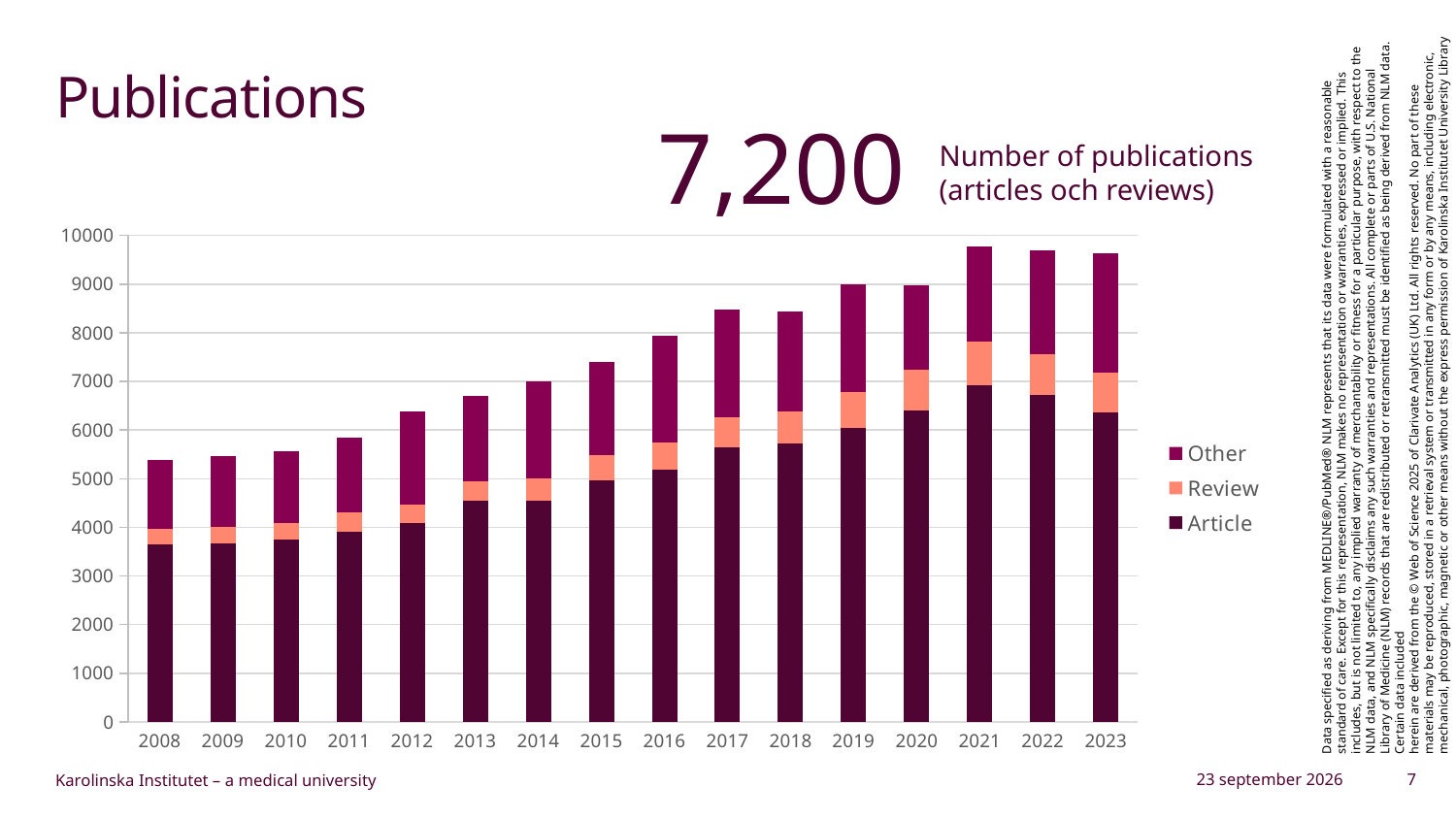
Which series is shown at the bottom of each stacked bar? Article Is the Article value for 2021 greater or less than 6000? greater What kind of chart is shown on the slide? Stacked bar chart How many years are shown on the x axis of the chart? 16 What are the three series listed in the chart's legend? Other, Review, Article Which year has the larger Article value, 2008 or 2021? 2021 Which year has the larger total number of publications, 2010 or 2015? 2015 Is the total number of publications in 2023 greater or less than 9000? greater Do the total publication counts generally rise or fall from 2008 to 2023? rise Is the total number of publications in 2008 greater or less than 6000? less How many series does the chart's legend list? 3